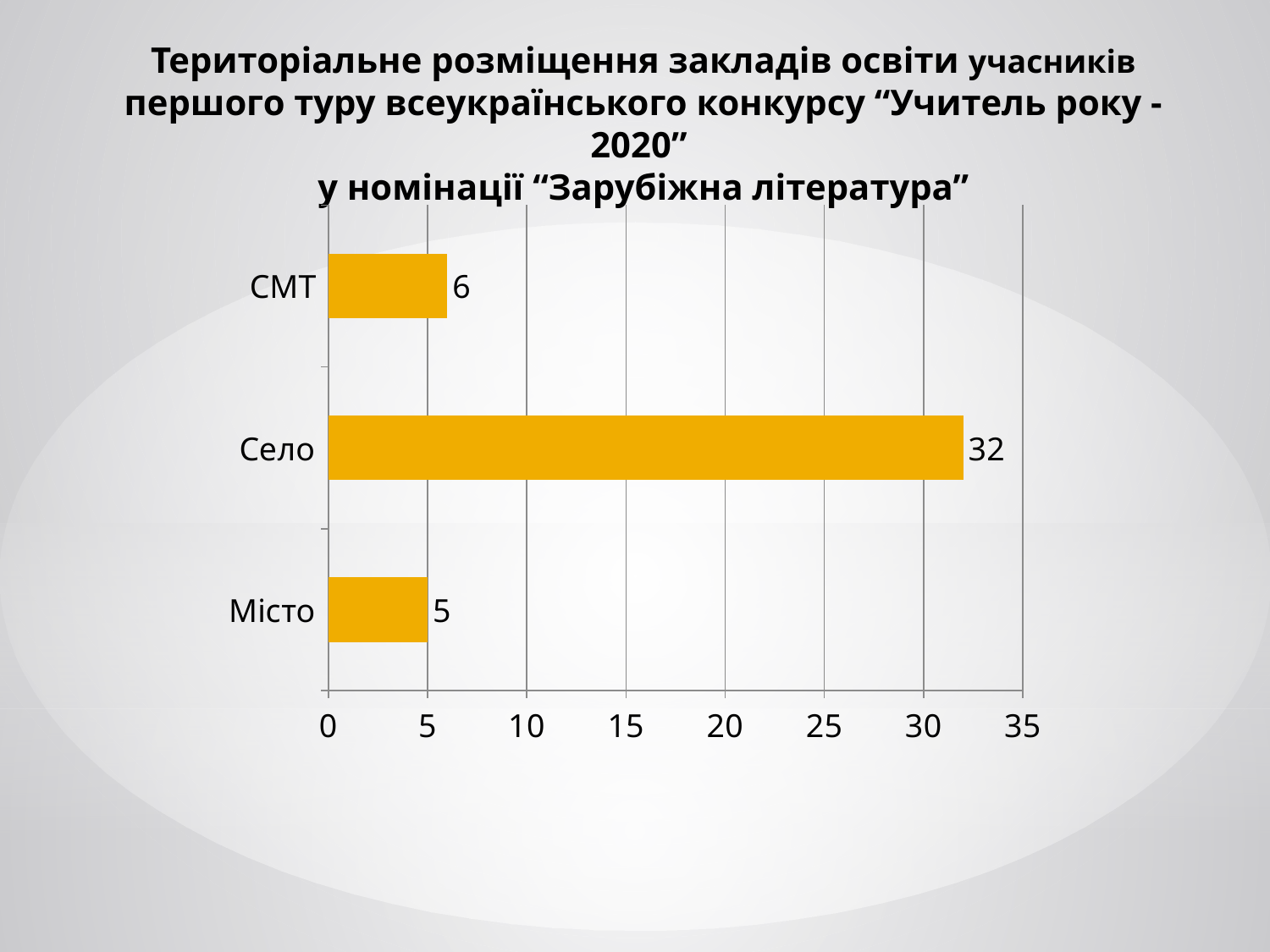
Which category has the highest value? Село What is the value for Місто? 5 Which is larger, the value for Село or the value for Місто? Село How many categories are shown in the chart? 3 What is the value for СМТ? 6 What is the difference between the values for СМТ and Місто? 1 What kind of chart is shown on the slide? bar chart What is the difference between the values for Село and СМТ? 26 Is the value for Село greater or less than 30? greater What is the value for Село? 32 What is the highest value shown on the horizontal axis? 35 Which category has the lowest value? Місто